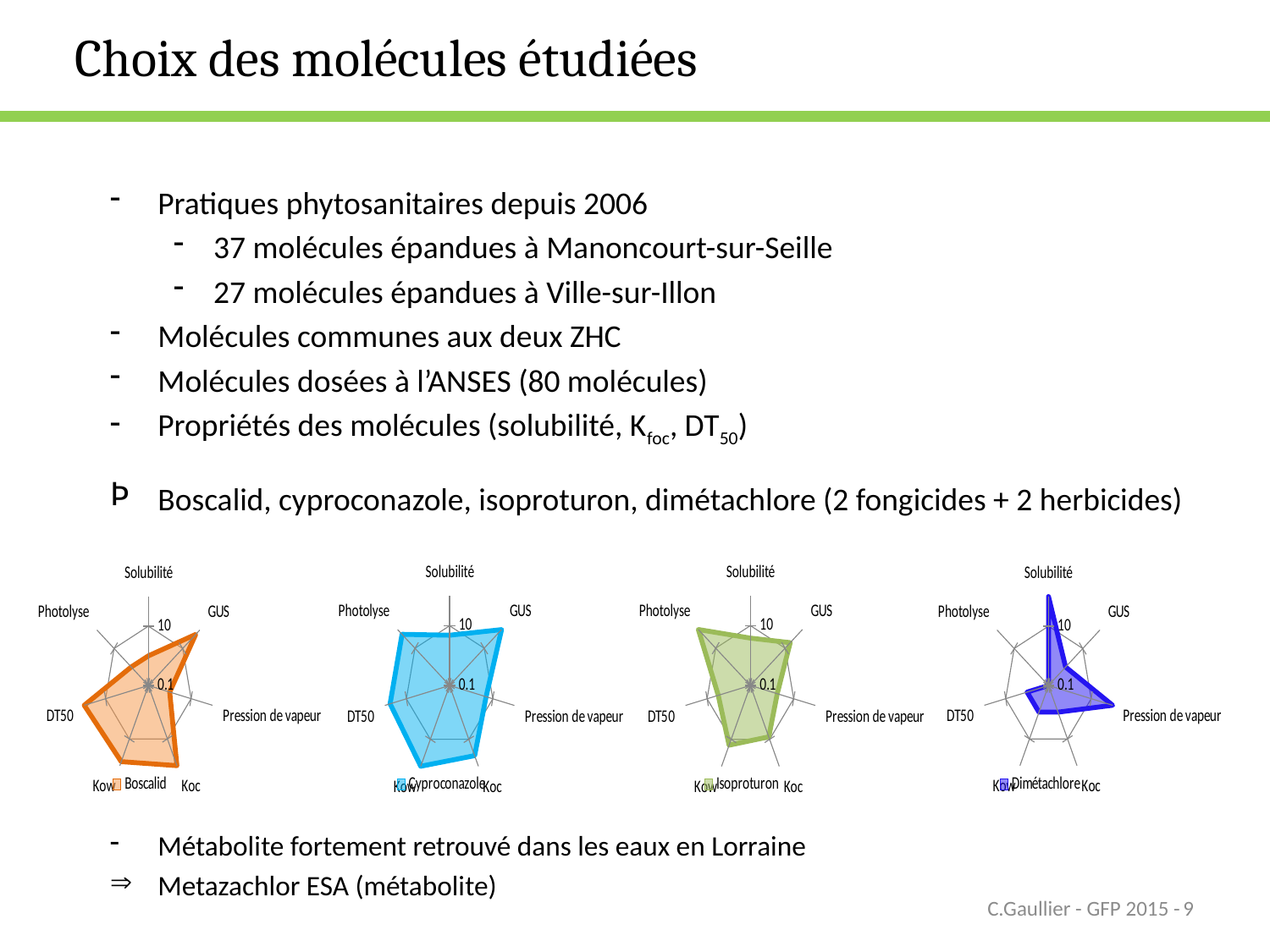
How many series does the legend of the Cyproconazole chart list? 1 In the Cyproconazole chart, is the value for Photolyse greater or less than 10? greater What colour is the filled area in the Dimétachlore radar chart? dark blue What is the legend entry of the third radar chart from the left? Isoproturon How many radar charts are shown on the slide? 4 In the Dimétachlore chart, is the value for Solubilité greater or less than 10? greater Which axis label appears at the top of each radar chart? Solubilité How many axes (properties) does the Boscalid radar chart have? 7 In the Boscalid chart, is the value for DT50 greater or less than 10? greater What kind of chart is used for Boscalid on this slide? radar chart